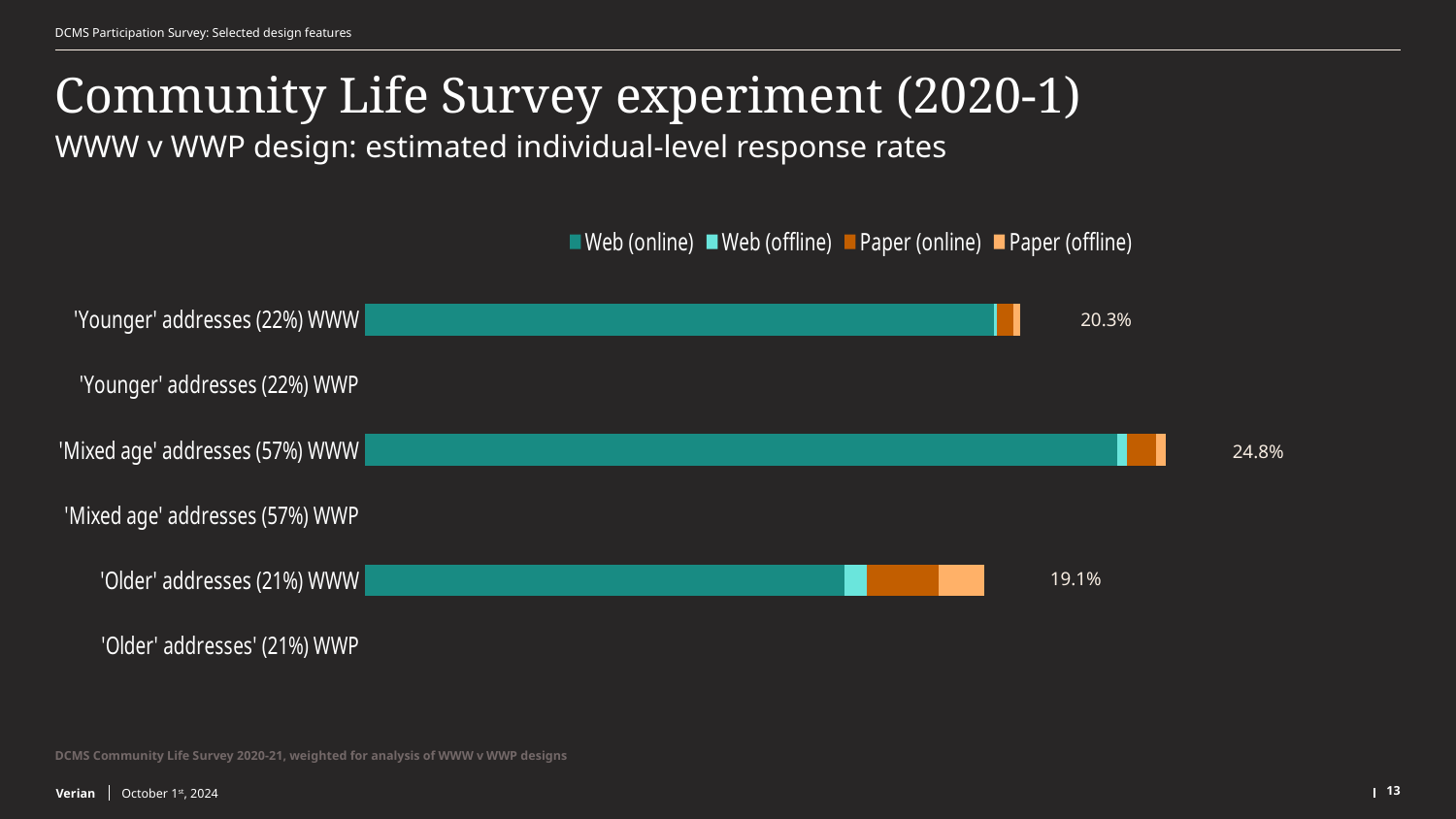
What kind of chart is shown on the slide? Stacked bar chart Which category has the highest total response rate on the chart? 'Mixed age' addresses (57%) WWW What is the total response rate shown for 'Younger' addresses (22%) WWW? 20.3% How many categories are listed on the vertical axis of the chart? 6 What is the difference between the total response rates for 'Mixed age' addresses (57%) WWW and 'Younger' addresses (22%) WWW? 4.5 percentage points What is the total response rate shown for 'Mixed age' addresses (57%) WWW? 24.8% Which series makes up the largest segment of each plotted bar? Web (online) What is the total response rate shown for 'Older' addresses (21%) WWW? 19.1% What is the difference between the total response rates for 'Younger' addresses (22%) WWW and 'Older' addresses (21%) WWW? 1.2 percentage points Which has a higher total response rate: 'Younger' addresses (22%) WWW or 'Older' addresses (21%) WWW? 'Younger' addresses (22%) WWW Among the bars with a printed total, which category has the lowest response rate? 'Older' addresses (21%) WWW How many series does the legend list? 4